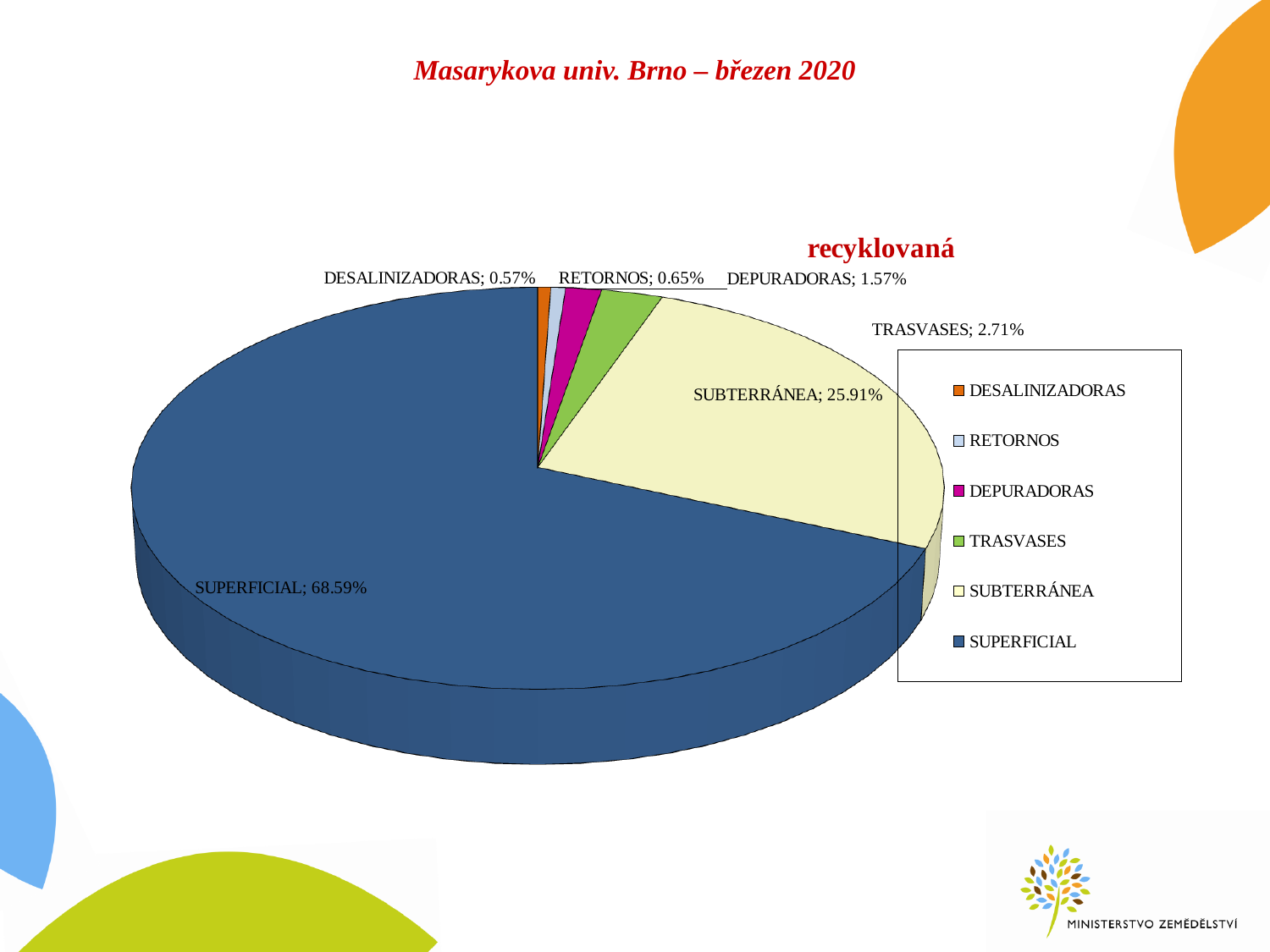
What is the value shown for RETORNOS? 0.65% What is the value shown for DEPURADORAS? 1.57% What colour is the SUBTERRÁNEA slice? Pale yellow How many categories does the legend list? 6 Which category has the smallest slice of the pie? DESALINIZADORAS What is the value shown for TRASVASES? 2.71% What kind of chart is shown on the slide? Pie chart Which is larger, the share for TRASVASES or the share for DEPURADORAS? TRASVASES What is the difference between the SUPERFICIAL and SUBTERRÁNEA shares? 42.68% Which category has the largest slice of the pie? SUPERFICIAL What share of the pie does SUPERFICIAL have? 68.59% What is the value shown for SUBTERRÁNEA? 25.91%